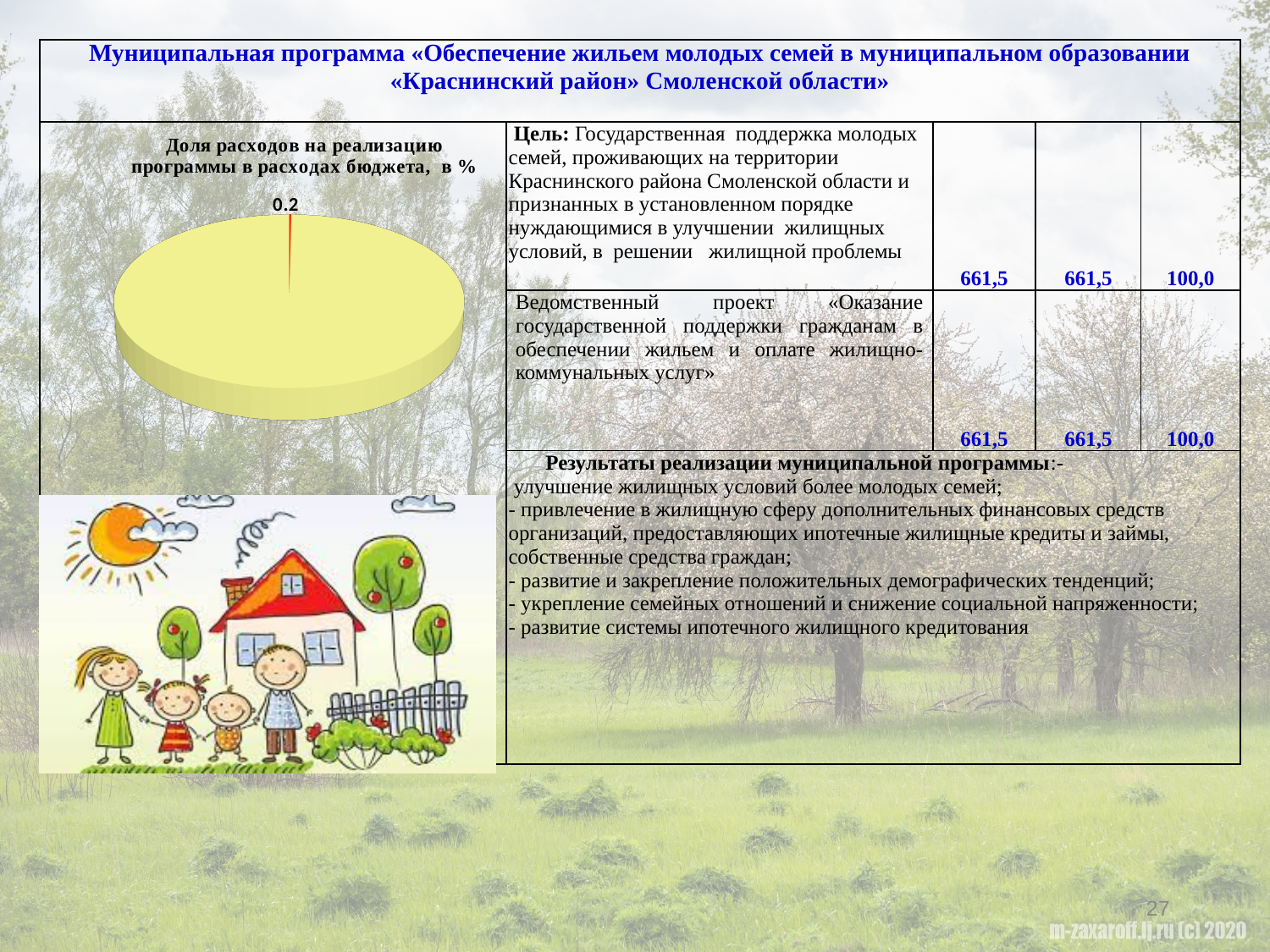
Which slice of the pie chart is the smallest? the red slice labelled 0.2 What is the title of the pie chart? Доля расходов на реализацию программы в расходах бюджета, в % What value is printed as the data label on the pie chart? 0.2 In the pie chart, which slice is larger: the yellow slice or the red slice? the yellow slice What colour is the slice labelled 0.2 in the pie chart? red How many slices are visible in the pie chart? 2 What kind of chart is shown on the left of the slide? pie chart